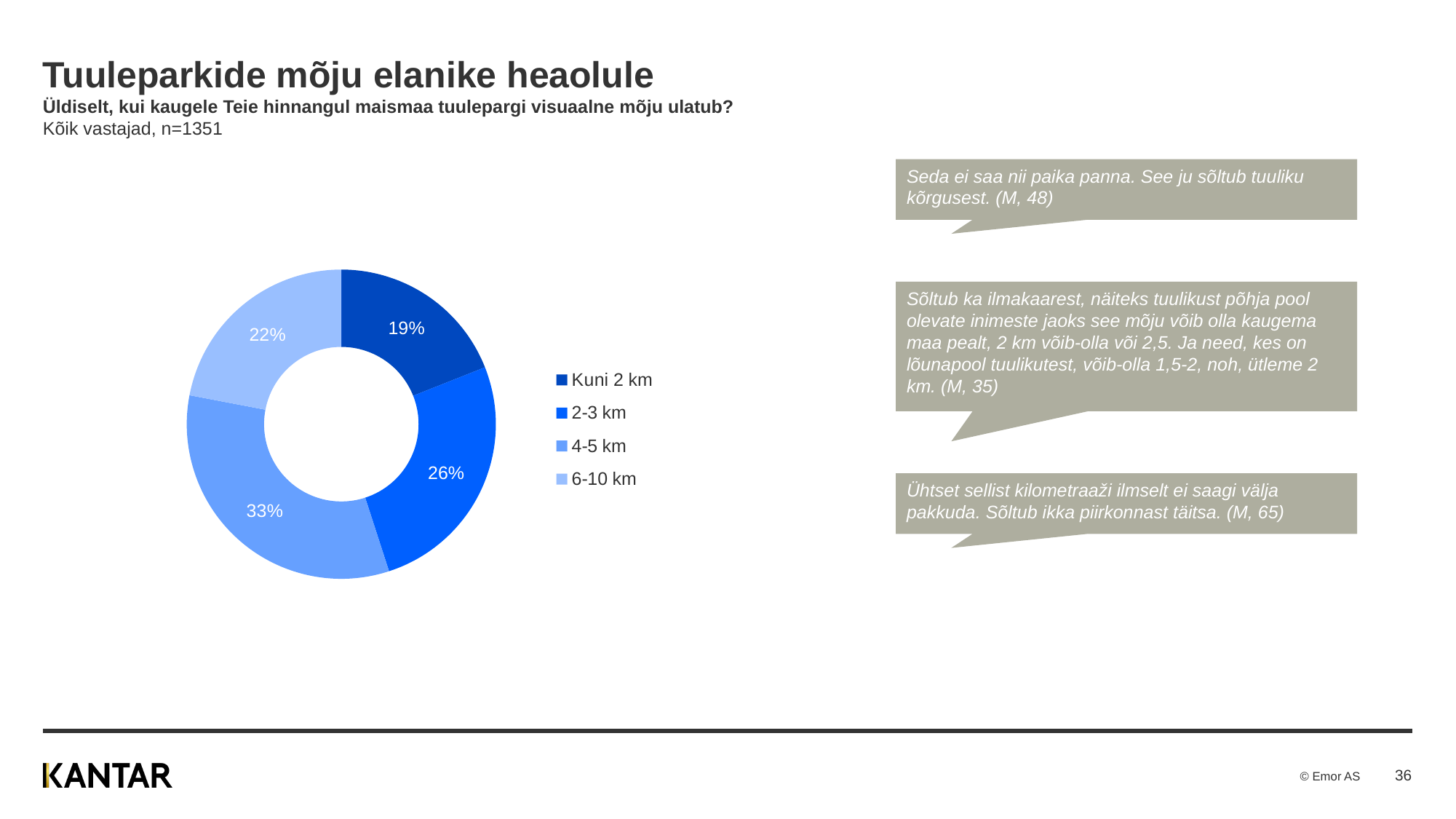
What kind of chart is shown on the slide? Donut (pie) chart What percentage of respondents chose "4-5 km"? 33% How many entries does the legend list? 4 Which category has the smallest share of the chart? Kuni 2 km What percentage of respondents chose "Kuni 2 km"? 19% Which category has the largest share of the chart? 4-5 km What is the difference in percentage points between the "4-5 km" and "Kuni 2 km" slices? 14 What percentage of respondents chose "6-10 km"? 22% How many categories are shown in the chart? 4 Which is larger, the share for "2-3 km" or the share for "6-10 km"? 2-3 km What percentage of respondents chose "2-3 km"? 26% What is the sample size stated on the slide? n=1351